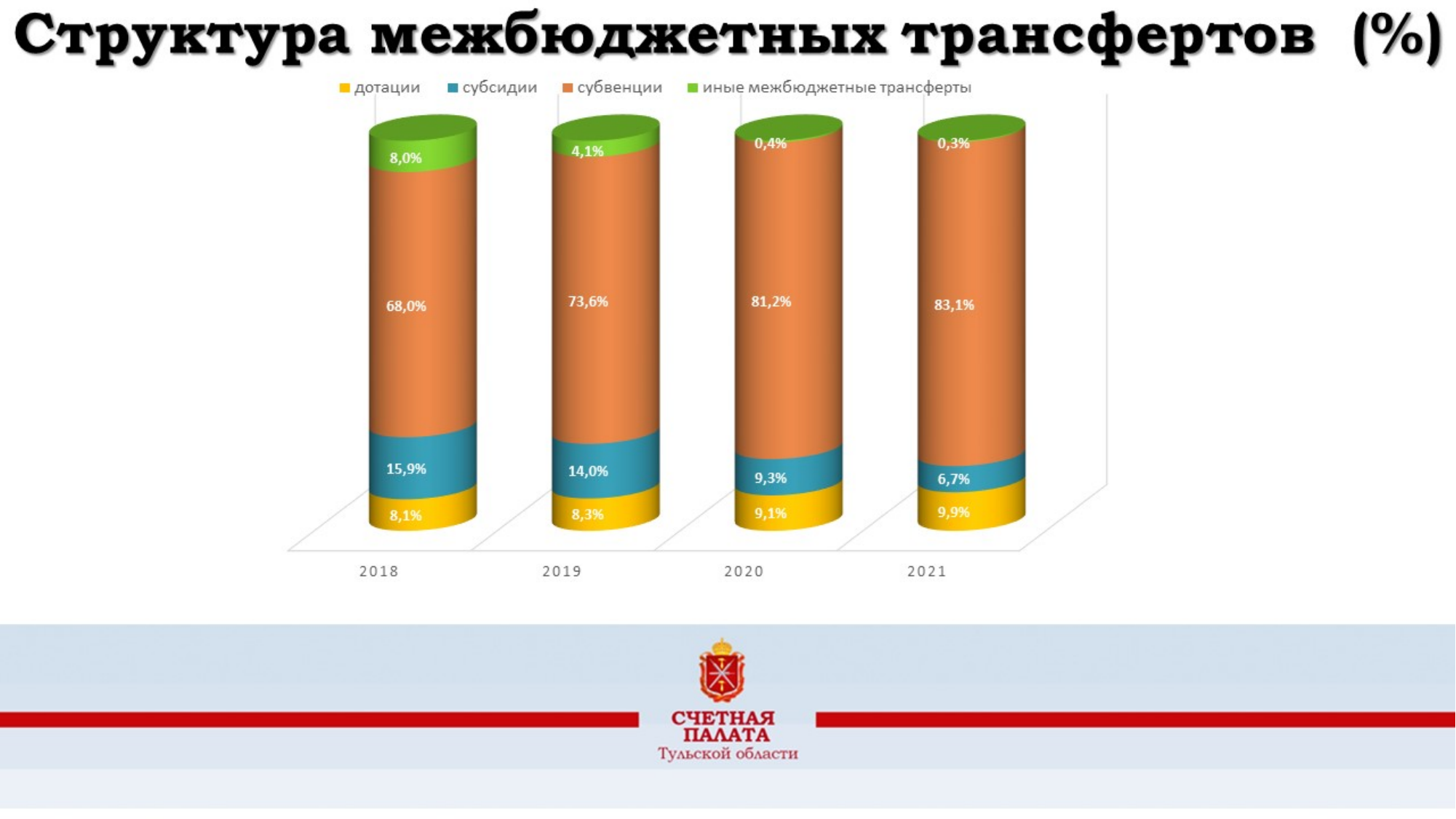
What is the value for иные межбюджетные трансферты in 2019? 4,1% In which year is the share of субсидии the lowest? 2021 What is the difference between the субвенции share in 2021 and in 2018? 15,1% What is the value for дотации in 2020? 9,1% How many years are shown on the x axis? 4 What is the value for субсидии in 2018? 15,9% What is the value for субвенции in 2021? 83,1% Which is larger: the дотации share in 2021 or the субсидии share in 2021? дотации (9,9%) In which year is the share of субвенции the highest? 2021 What kind of chart is shown on the slide? Stacked bar chart How many series does the legend list? 4 Does the share of субвенции rise or fall from 2018 to 2021? Rises